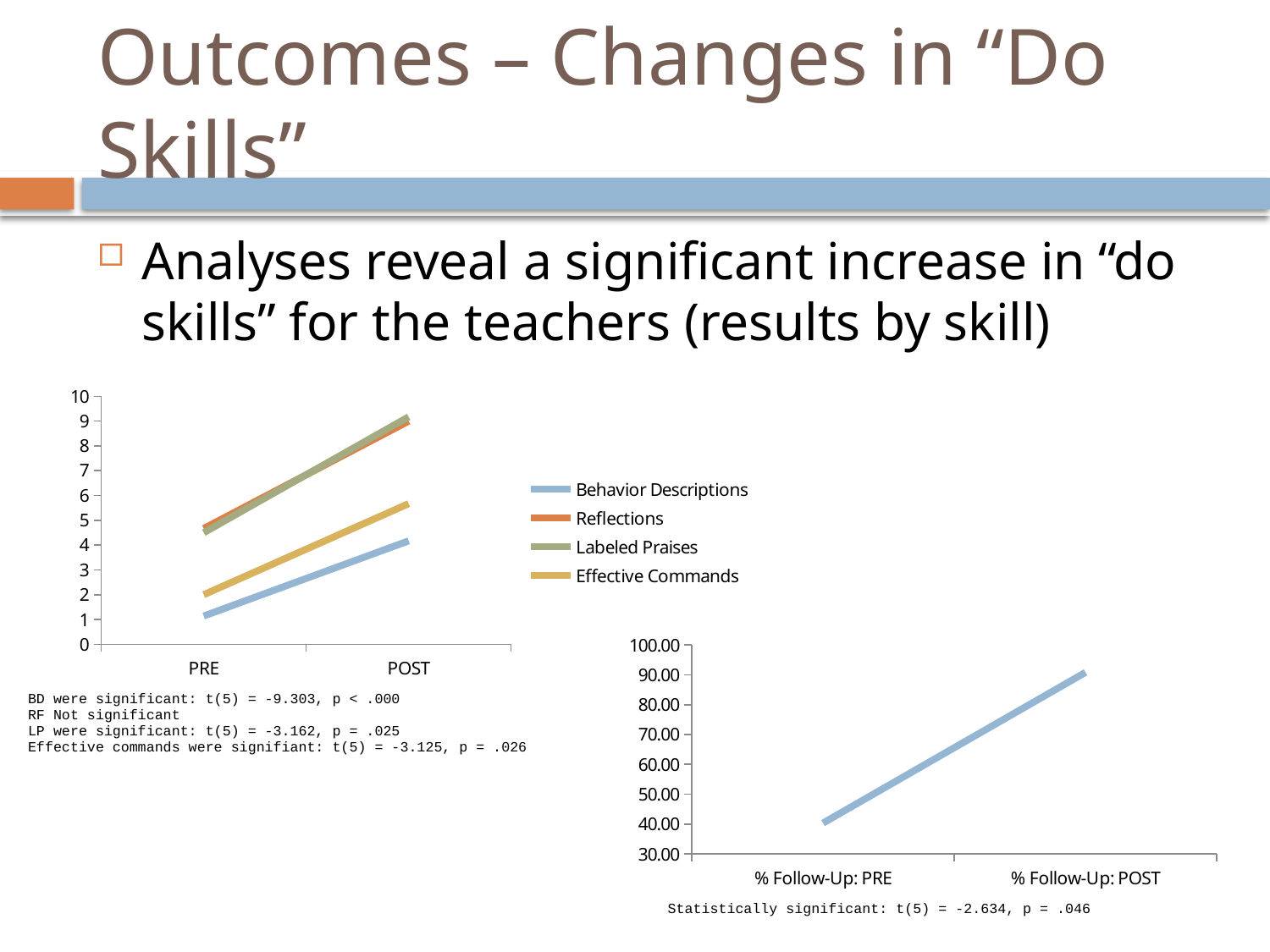
What kind of chart is the chart on the bottom right of the slide? line chart In the chart on the left, is the POST value for Behavior Descriptions greater or less than 5? less In the chart on the left, which series has the lowest value at PRE? Behavior Descriptions In the chart on the left, is the POST value for Labeled Praises greater or less than 8? greater In the chart on the left, how many series does the legend list? 4 In the chart on the left, is the PRE value for Effective Commands greater or less than 3? less In the chart on the bottom right, does the line rise or fall from % Follow-Up: PRE to % Follow-Up: POST? rise What kind of chart is the chart on the left of the slide? line chart In the chart on the left, does the Behavior Descriptions line rise or fall from PRE to POST? rise In the chart on the left, which is larger at POST: Effective Commands or Behavior Descriptions? Effective Commands In the chart on the left, how many categories are shown on the x axis? 2